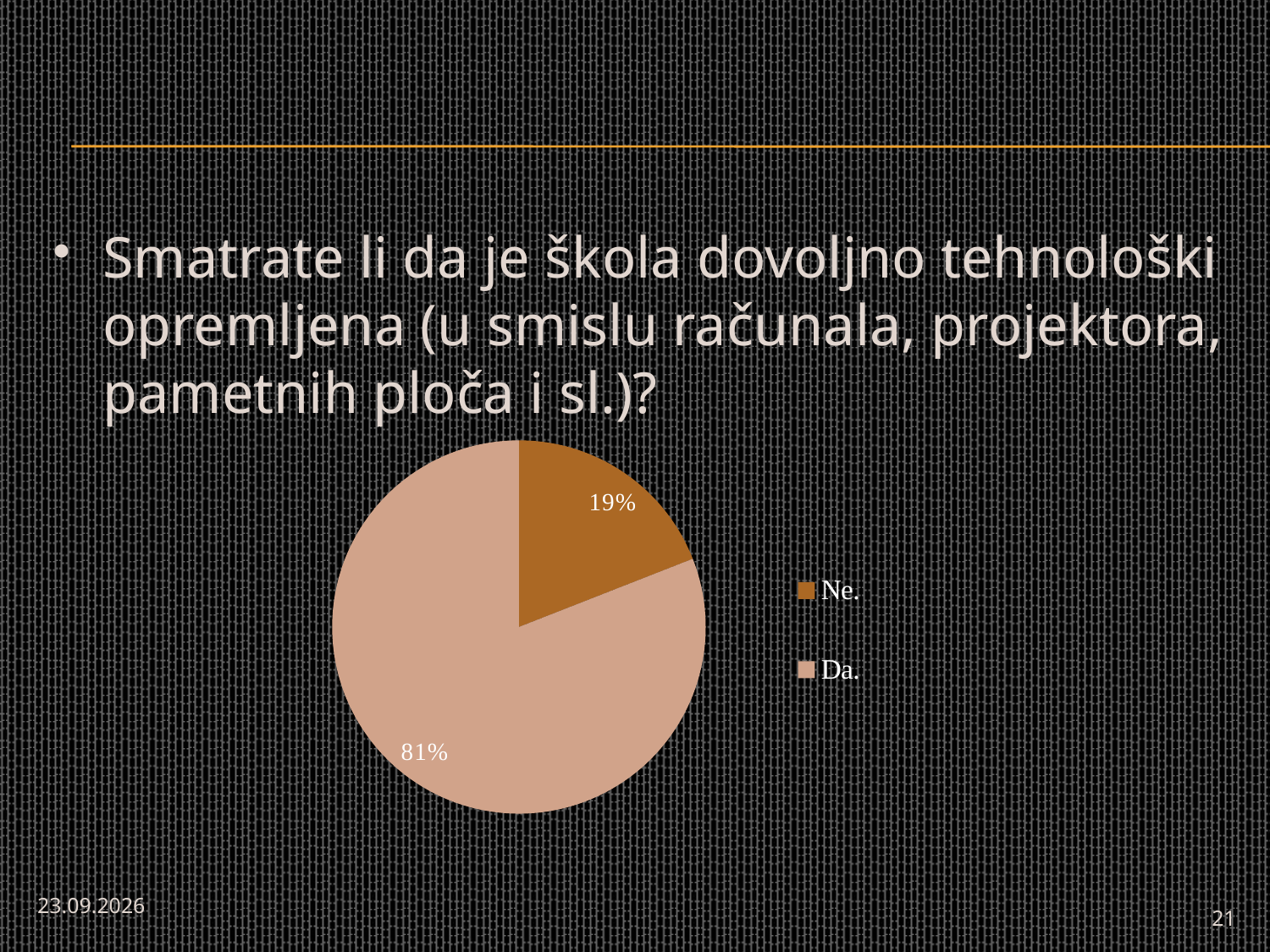
What kind of chart is shown on the slide? pie chart What share of the pie does "Ne." represent? 19% Which legend entry is shown in the darker orange-brown colour? Ne. Which category has the smallest slice of the pie? Ne. How many slices does the pie chart have? 2 What is the difference in percentage points between the "Da." and "Ne." slices? 62 Which category has the largest slice of the pie? Da. Which is larger, the "Da." slice or the "Ne." slice? Da. How many entries does the legend list? 2 What share of the pie does "Da." represent? 81% Which legend entry is shown in the lighter tan colour? Da.